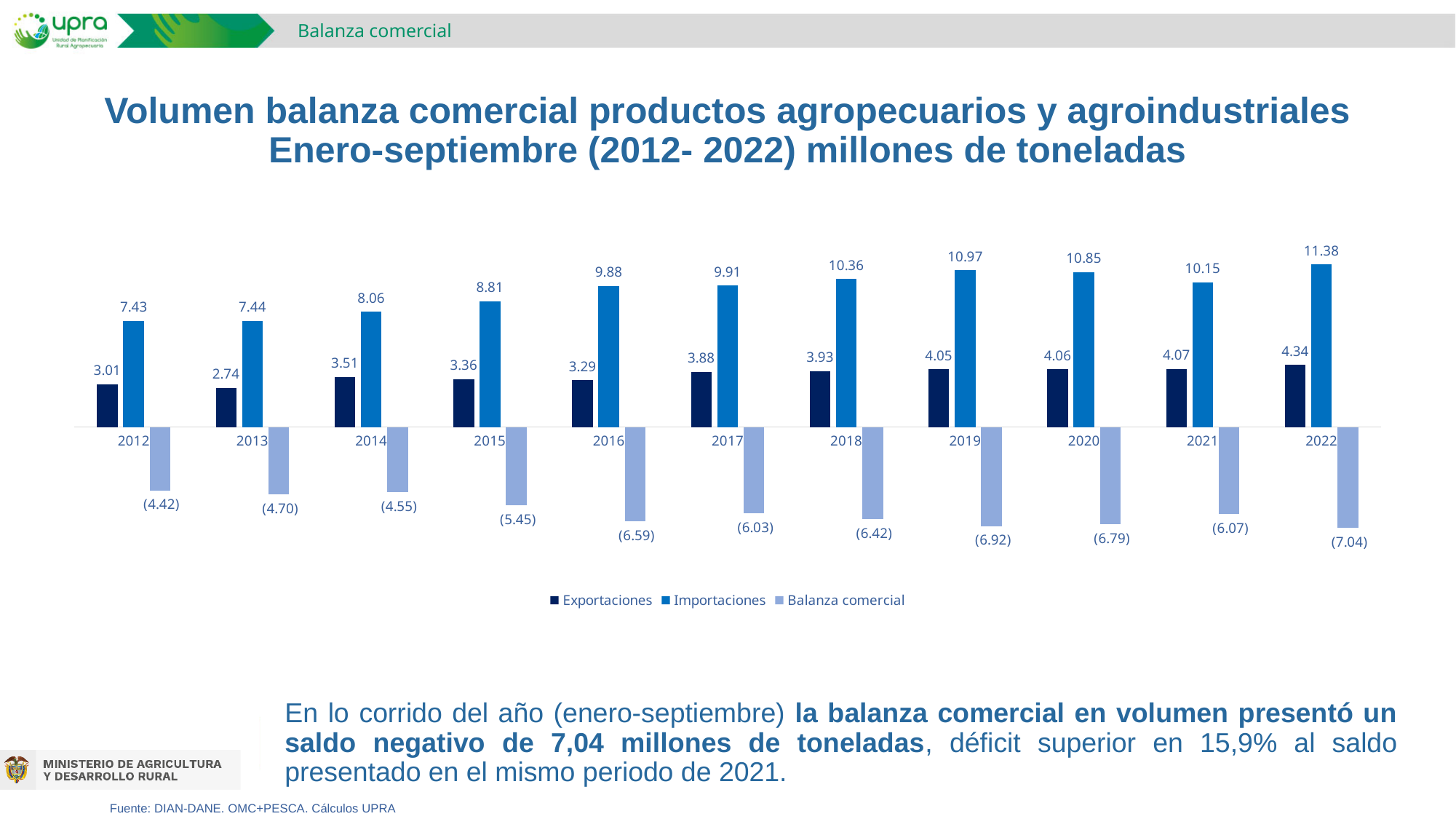
How many years are shown on the x axis? 11 Which year has the lowest Exportaciones value? 2013 Which series is shown in light blue in the legend? Balanza comercial What is the value of Importaciones for 2022? 11.38 What is the difference between Importaciones and Exportaciones in 2012? 4.42 Do the Importaciones values generally rise or fall from 2012 to 2022? Rise Which is larger, Exportaciones in 2018 or Exportaciones in 2017? Exportaciones in 2018 How many series does the legend list? 3 What is the value of Balanza comercial for 2019? (6.92) What kind of chart is shown on the slide? Bar chart What is the value of Exportaciones for 2013? 2.74 Which year has the highest Importaciones value? 2022